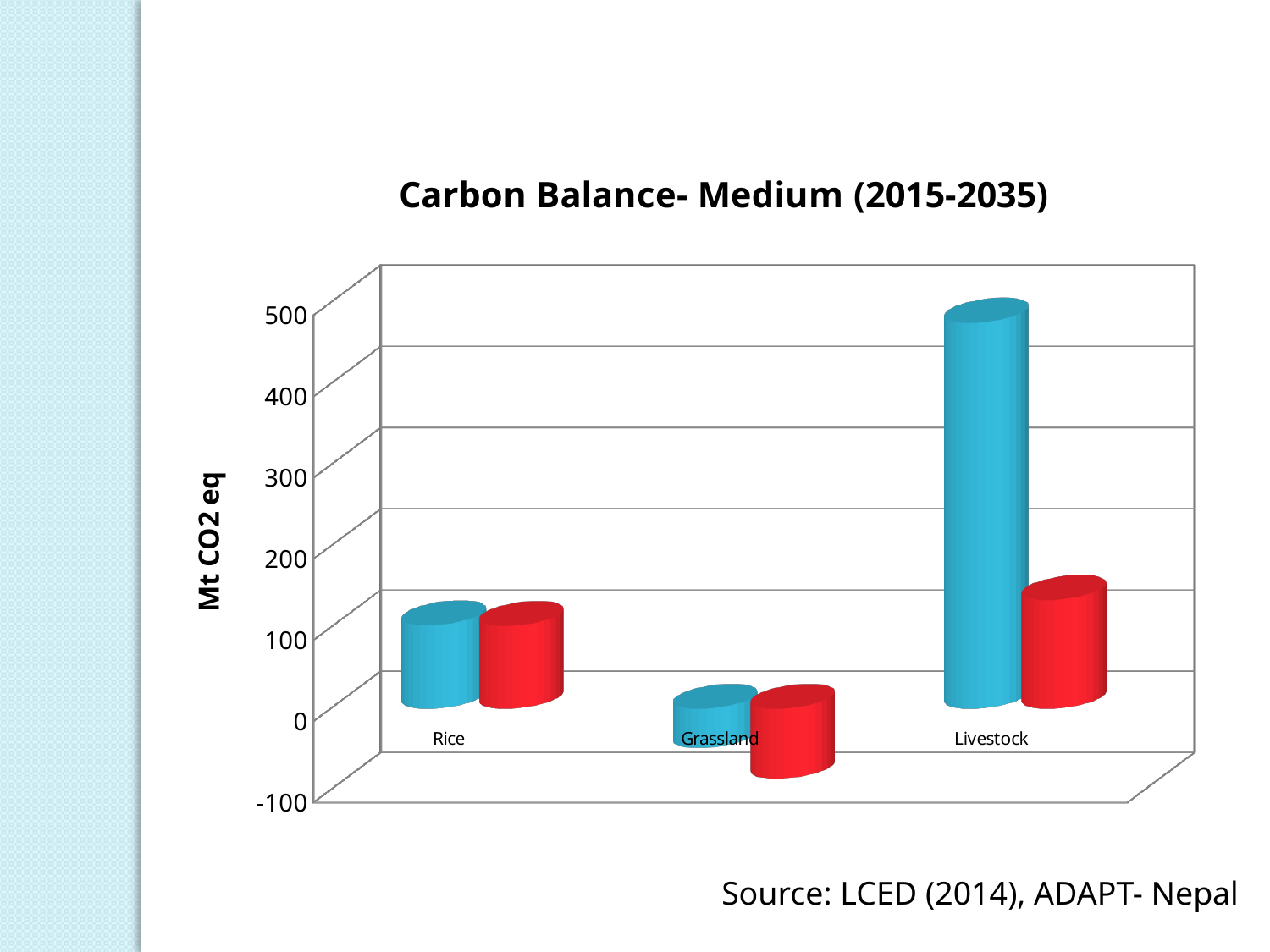
What type of chart is shown on the slide? bar chart Which is larger, the blue bar for Livestock or the blue bar for Rice? Livestock How many categories are shown on the x axis of the chart? 3 What is the label on the vertical axis of the chart? Mt CO2 eq Which category has the lowest red bar? Grassland What is the title of the chart? Carbon Balance- Medium (2015-2035) Is the value of the red bar for Livestock greater or less than 300? less For Livestock, which bar is larger, the blue one or the red one? the blue one Is the value of the blue bar for Livestock greater or less than 300? greater Which category has the highest blue bar? Livestock Which category has the lowest blue bar? Grassland Is the value of the red bar for Grassland greater or less than 0? less